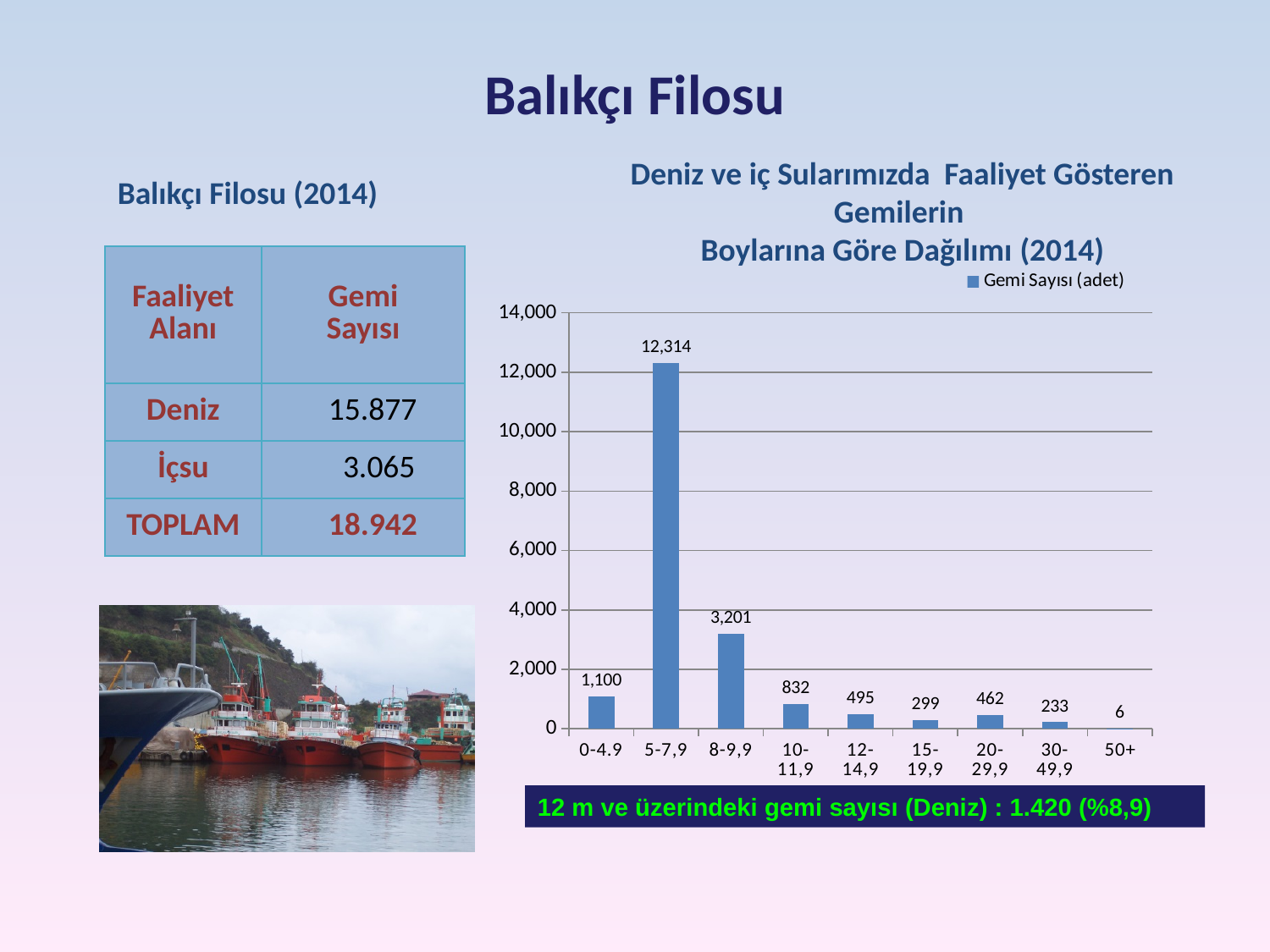
What kind of chart is shown? bar chart What is the value for the 50+ category? 6 Which category has the highest value? 5-7,9 Which is larger, the value for 15-19,9 or the value for 20-29,9? 20-29,9 What series name does the legend show? Gemi Sayısı (adet) What is the difference between the values for 10-11,9 and 12-14,9? 337 What is the value for the 5-7,9 category? 12,314 What is the value for the 8-9,9 category? 3,201 Which category has the lowest value? 50+ How many categories are shown on the x axis? 9 What is the value for the 0-4.9 category? 1,100 Is the value for 8-9,9 greater or less than 4,000? less